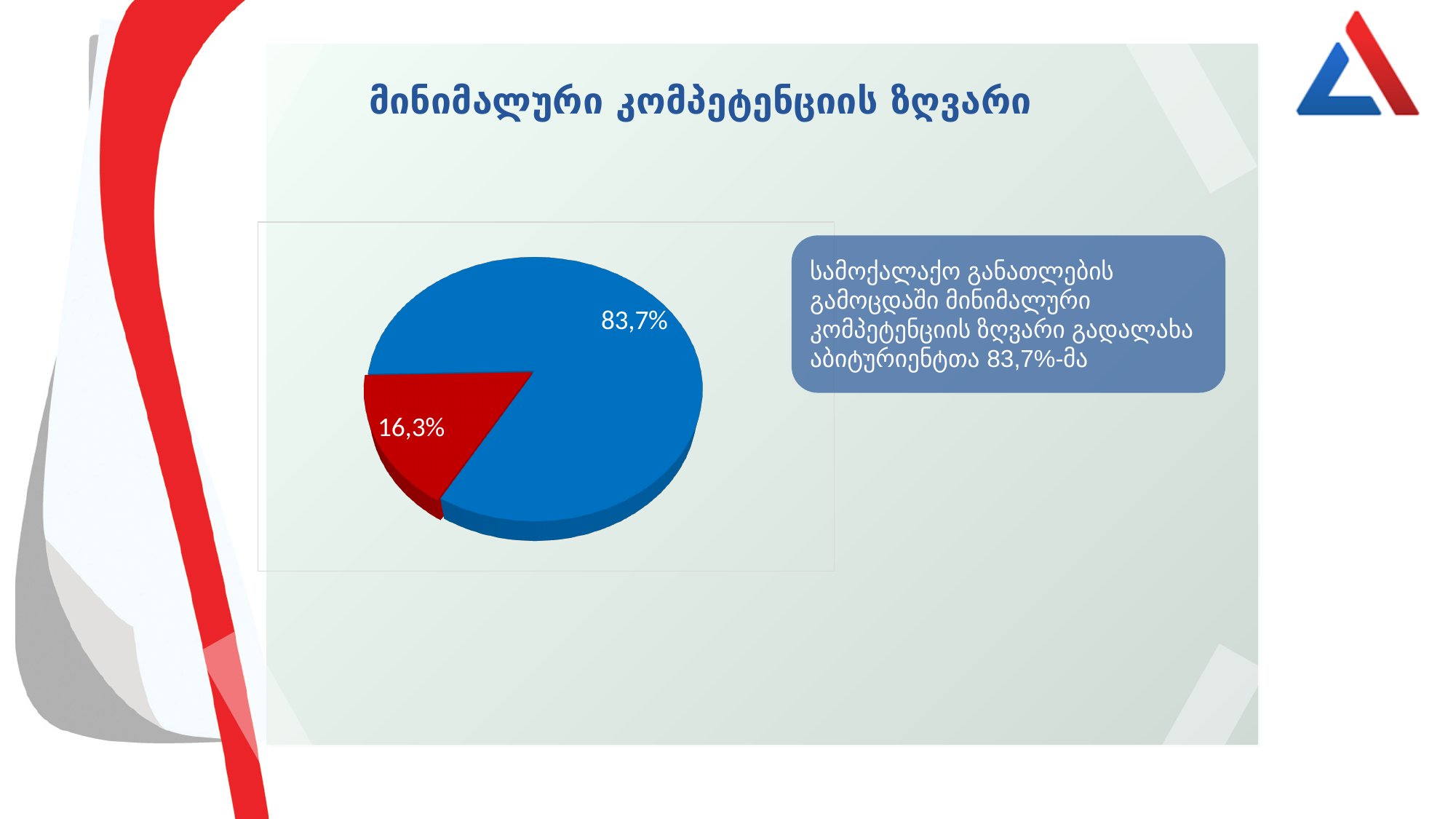
What share of the pie does the red slice represent? 16,3% What value is labelled on the red slice of the pie chart? 16,3% What kind of chart is shown on the slide? pie chart Which slice of the pie chart is the smallest? the red slice (16,3%) What is the difference between the blue slice (83,7%) and the red slice (16,3%) of the pie chart? 67,4 percentage points How many slices does the pie chart have? 2 What do the two labelled slices of the pie chart add up to? 100% Which slice of the pie chart is the largest? the blue slice (83,7%) What value is labelled on the blue slice of the pie chart? 83,7% Which is larger, the blue slice or the red slice of the pie chart? the blue slice What is the title of the slide containing the pie chart? მინიმალური კომპეტენციის ზღვარი What colour is the slice labelled 16,3% in the pie chart? red